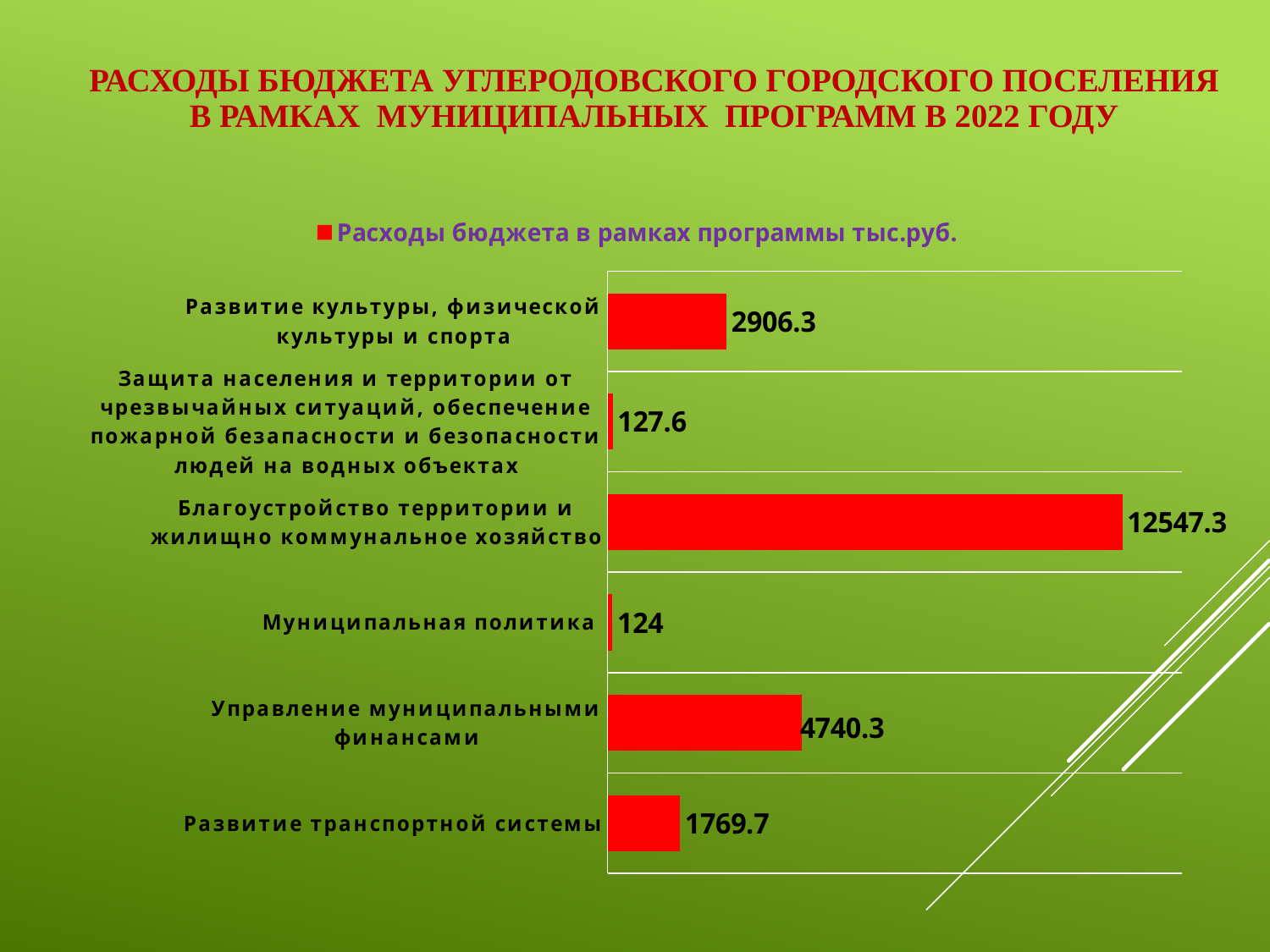
What is the value for Благоустройство территории и жилищно коммунальное хозяйство? 12547.3 What is the difference between the values for Развитие культуры, физической культуры и спорта and Развитие транспортной системы? 1136.6 What is the value for Развитие транспортной системы? 1769.7 What kind of chart is shown on the slide? Bar chart What is the value for Управление муниципальными финансами? 4740.3 What series name does the legend show? Расходы бюджета в рамках программы тыс.руб. How many categories are shown in the chart? 6 Which category has the highest value? Благоустройство территории и жилищно коммунальное хозяйство What is the value for Развитие культуры, физической культуры и спорта? 2906.3 Which is larger: the value for Управление муниципальными финансами or the value for Развитие культуры, физической культуры и спорта? Управление муниципальными финансами Which category has the lowest value? Муниципальная политика What is the difference between the values for Благоустройство территории и жилищно коммунальное хозяйство and Управление муниципальными финансами? 7807